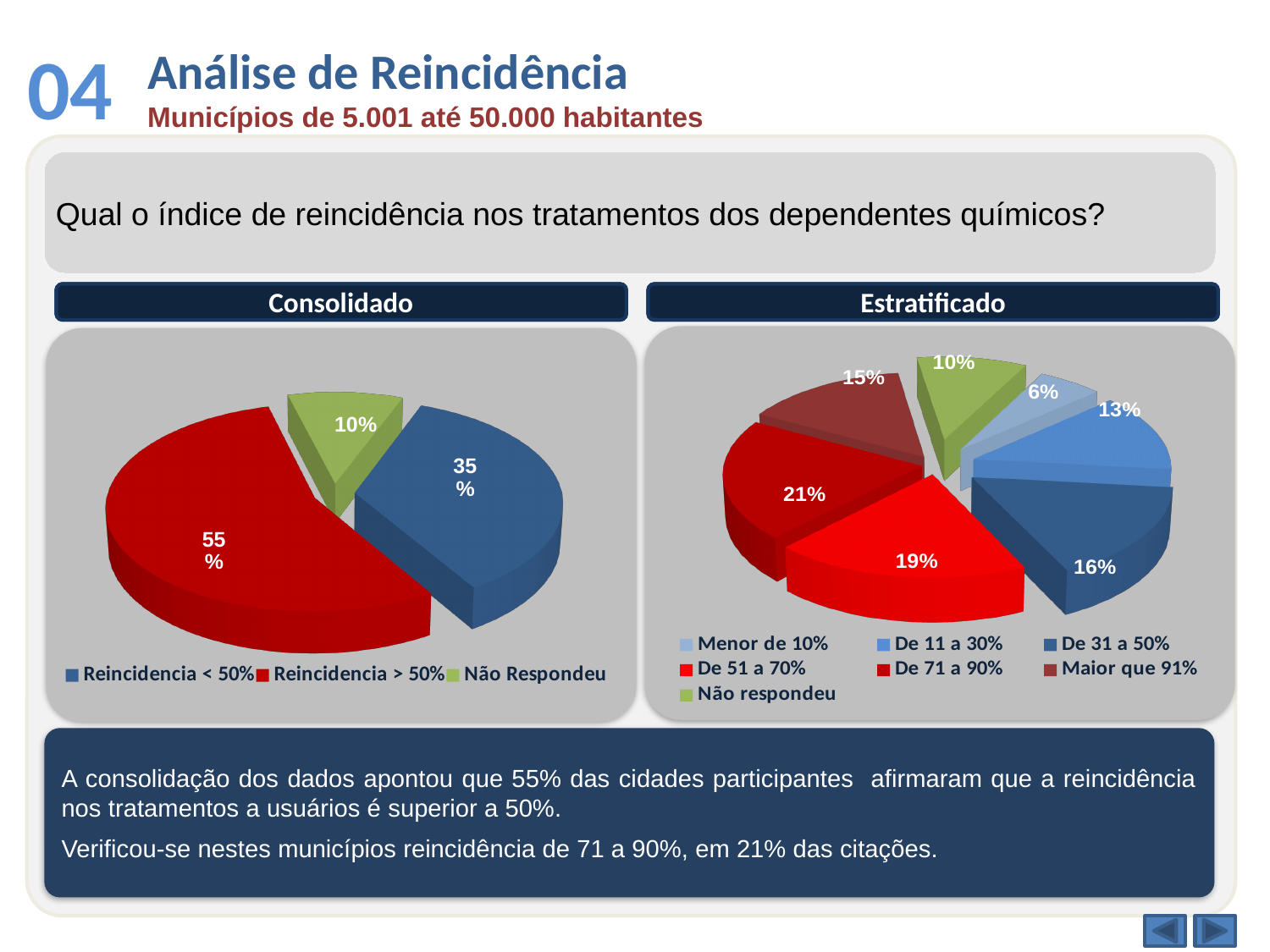
In the Estratificado chart, what colour is the Não respondeu slice? Green In the Consolidado chart, what is the value for Reincidencia < 50%? 35% In the Estratificado chart, which category has the largest slice? De 71 a 90% In the Consolidado chart, what is the value for Reincidencia > 50%? 55% In the Consolidado chart, what is the difference between Reincidencia > 50% and Reincidencia < 50%? 20 percentage points In the Consolidado chart, which category has the smallest slice? Não Respondeu In the Estratificado chart, what is the value for De 71 a 90%? 21% What kind of chart is the Consolidado chart? Pie chart In the Consolidado chart, how many categories does the legend list? 3 In the Estratificado chart, what is the value for Menor de 10%? 6% In the Estratificado chart, which is larger: De 51 a 70% or De 31 a 50%? De 51 a 70% In the Estratificado chart, how many categories does the legend list? 7